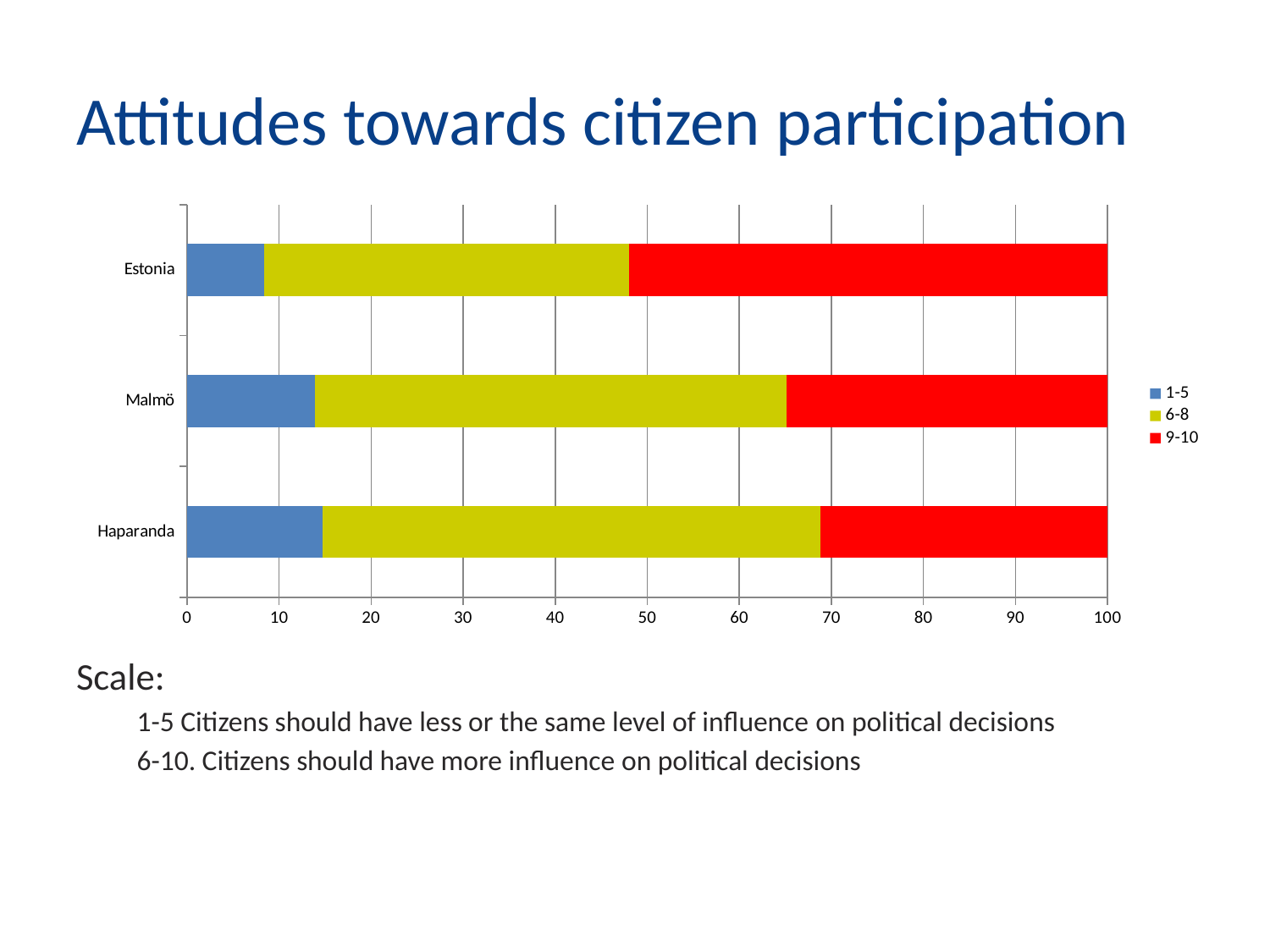
What kind of chart is shown on the slide? bar chart Is the value of the 9-10 segment for Estonia greater or less than 50? greater Which category has the smallest 1-5 segment? Estonia How many categories (places) are shown on the y axis of the chart? 3 Which category has the largest 9-10 segment? Estonia Is the value of the 9-10 segment for Malmö greater or less than 40? less What is the title of the slide containing the chart? Attitudes towards citizen participation Is the value of the 1-5 segment for Malmö greater or less than 10? greater Which has the larger 9-10 segment, Estonia or Haparanda? Estonia What are the three series listed in the chart legend? 1-5, 6-8, 9-10 How many series does the chart legend list? 3